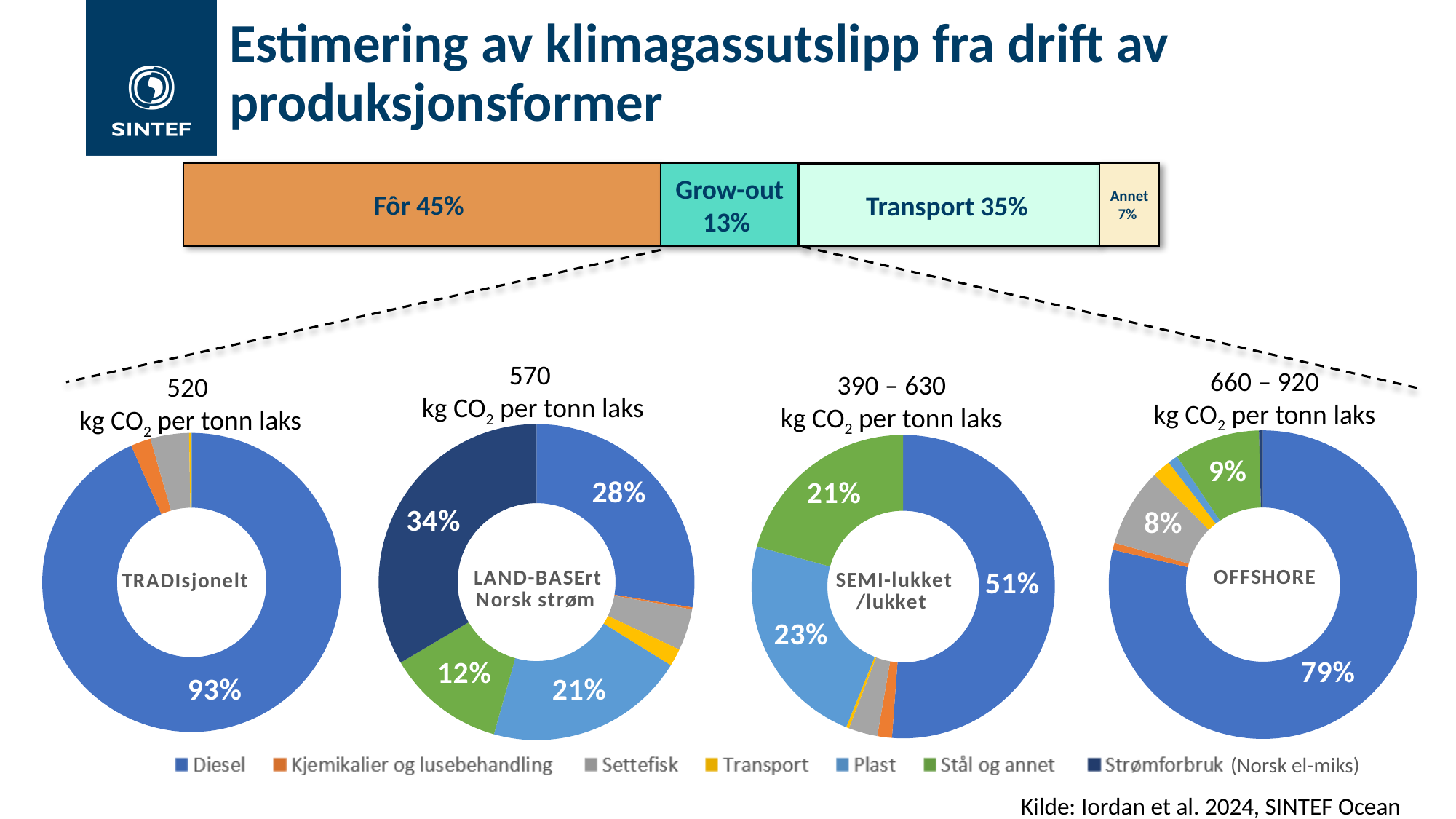
In the LAND-BASErt Norsk strøm donut chart, what share does Strømforbruk (Norsk el-miks) have? 34% What kind of chart is used for the four production forms (TRADIsjonelt, LAND-BASErt, SEMI-lukket/lukket, OFFSHORE)? Donut chart In the OFFSHORE donut chart, what share does Settefisk have? 8% In the SEMI-lukket/lukket donut chart, which category has the largest share? Diesel In the OFFSHORE donut chart, which is larger, the Stål og annet share or the Settefisk share? Stål og annet In the SEMI-lukket/lukket donut chart, what share does Plast have? 23% In the top stacked bar, what is the difference between the Fôr share and the Grow-out share? 32% How many entries does the legend below the donut charts list? 7 In the LAND-BASErt Norsk strøm donut chart, which labelled category has the largest share? Strømforbruk (Norsk el-miks) In the LAND-BASErt Norsk strøm donut chart, what is the difference between the Diesel share and the Plast share? 7% In the TRADIsjonelt donut chart, what share does Diesel have? 93% In the top stacked bar, what percentage is shown for Transport? 35%